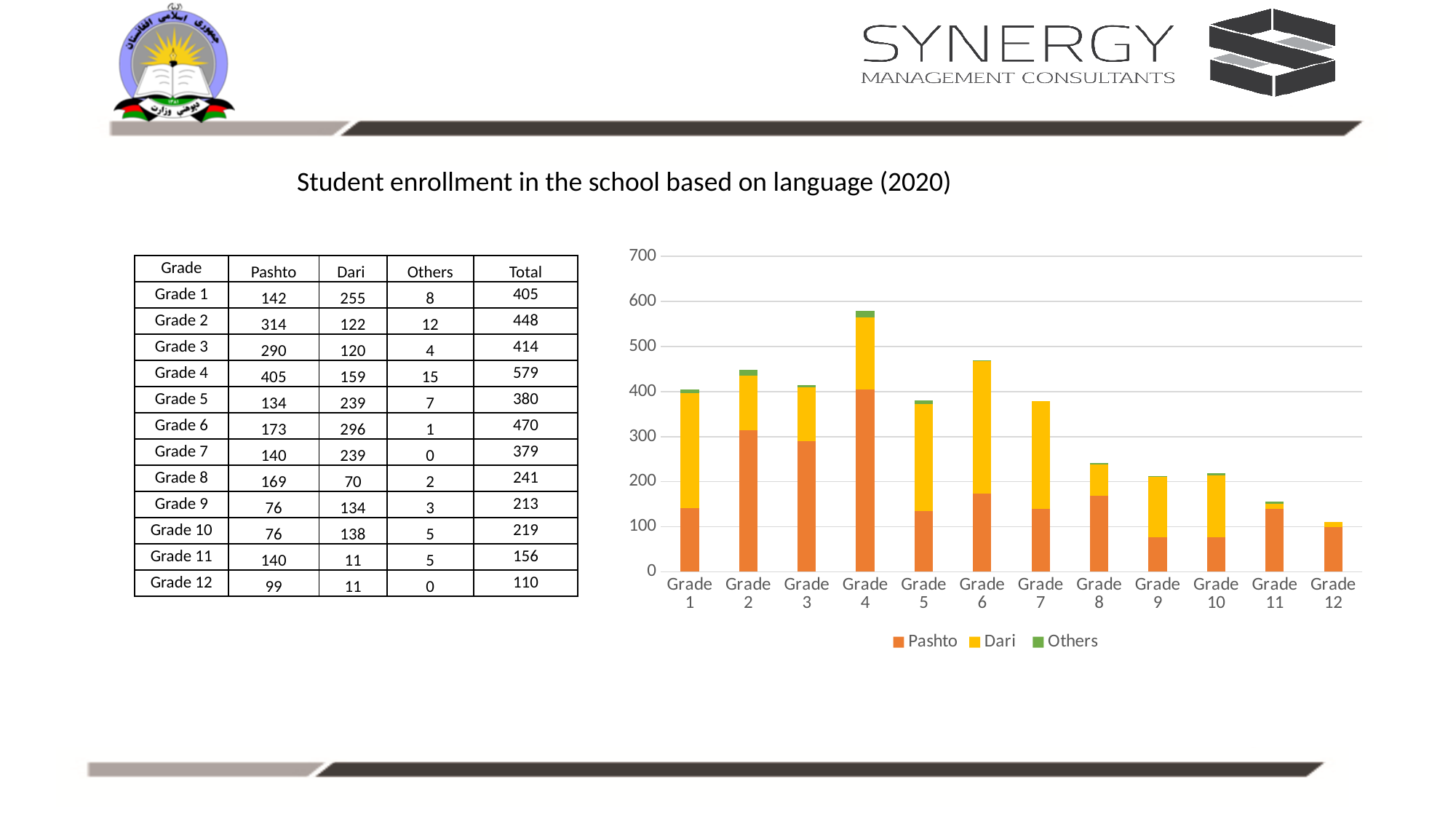
How many grades are plotted along the x axis of the chart? 12 What is the Dari enrollment for Grade 6? 296 What is the total enrollment for Grade 2 (the full stacked bar)? 448 Which grade has the tallest stacked bar in the chart? Grade 4 What kind of chart is shown on the slide? stacked bar chart Which is larger for Grade 1, the Pashto segment or the Dari segment? Dari Which grade has the shortest stacked bar in the chart? Grade 12 Which colour represents the Others series in the chart? green How many series does the chart legend list? 3 What is the difference between the total enrollment of Grade 4 and Grade 12? 469 What is the Pashto enrollment for Grade 4? 405 Is the total stacked bar for Grade 7 greater or less than 400? less